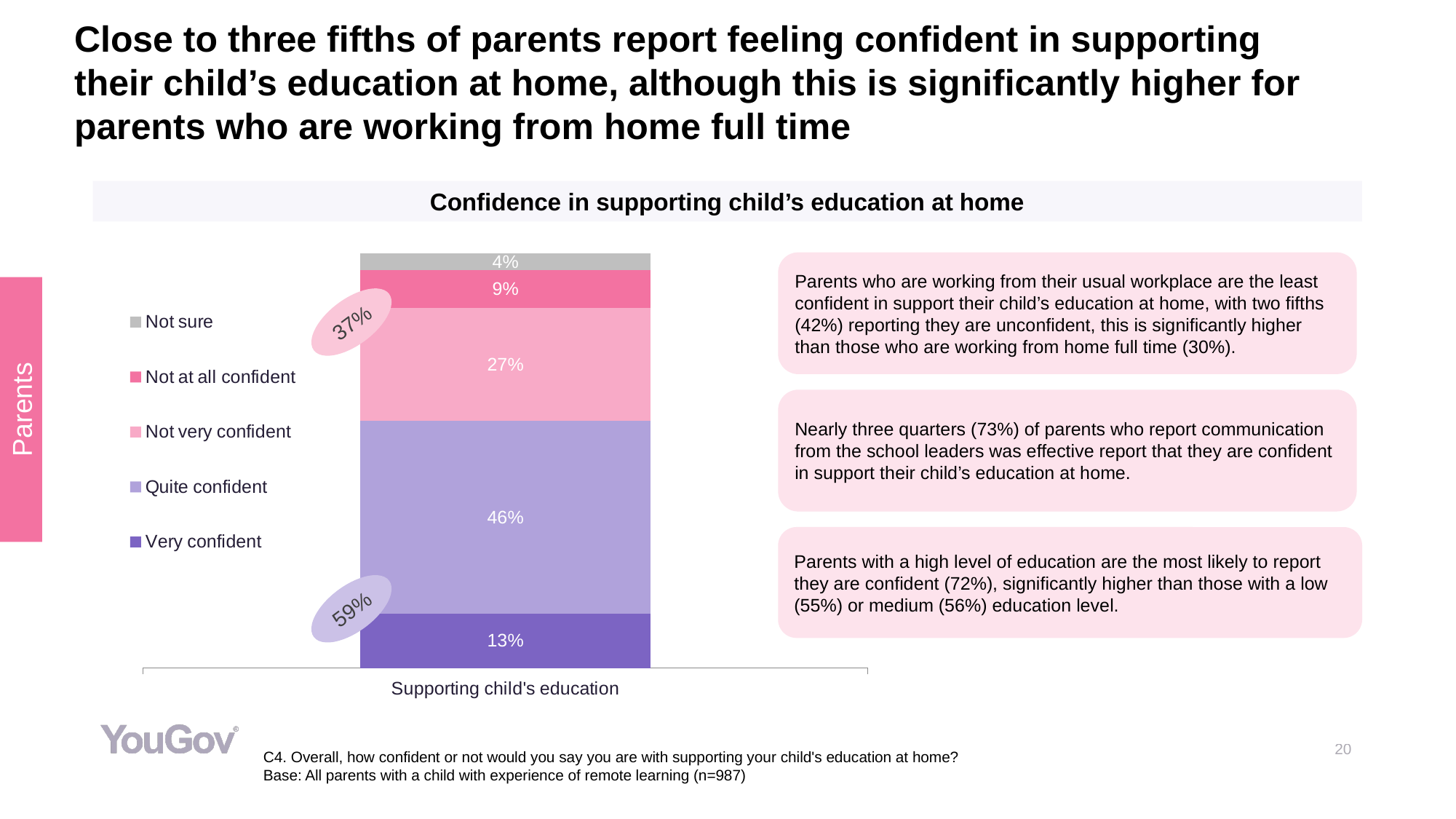
What percentage of parents are 'Not very confident'? 27% Which response category has the largest share of parents? Quite confident What percentage of parents are 'Quite confident' in supporting their child's education at home? 46% What is the difference between the 'Quite confident' and 'Not very confident' percentages? 19 percentage points How many series does the legend list? 5 What percentage of parents are 'Very confident'? 13% What kind of chart is shown on the slide? Stacked bar chart What is the combined percentage of parents who are 'Very confident' or 'Quite confident', as shown in the callout? 59% What percentage of parents answered 'Not sure'? 4% Which is larger: the 'Very confident' share or the 'Not at all confident' share? Very confident What percentage of parents are 'Not at all confident'? 9% Which response category has the smallest share of parents? Not sure